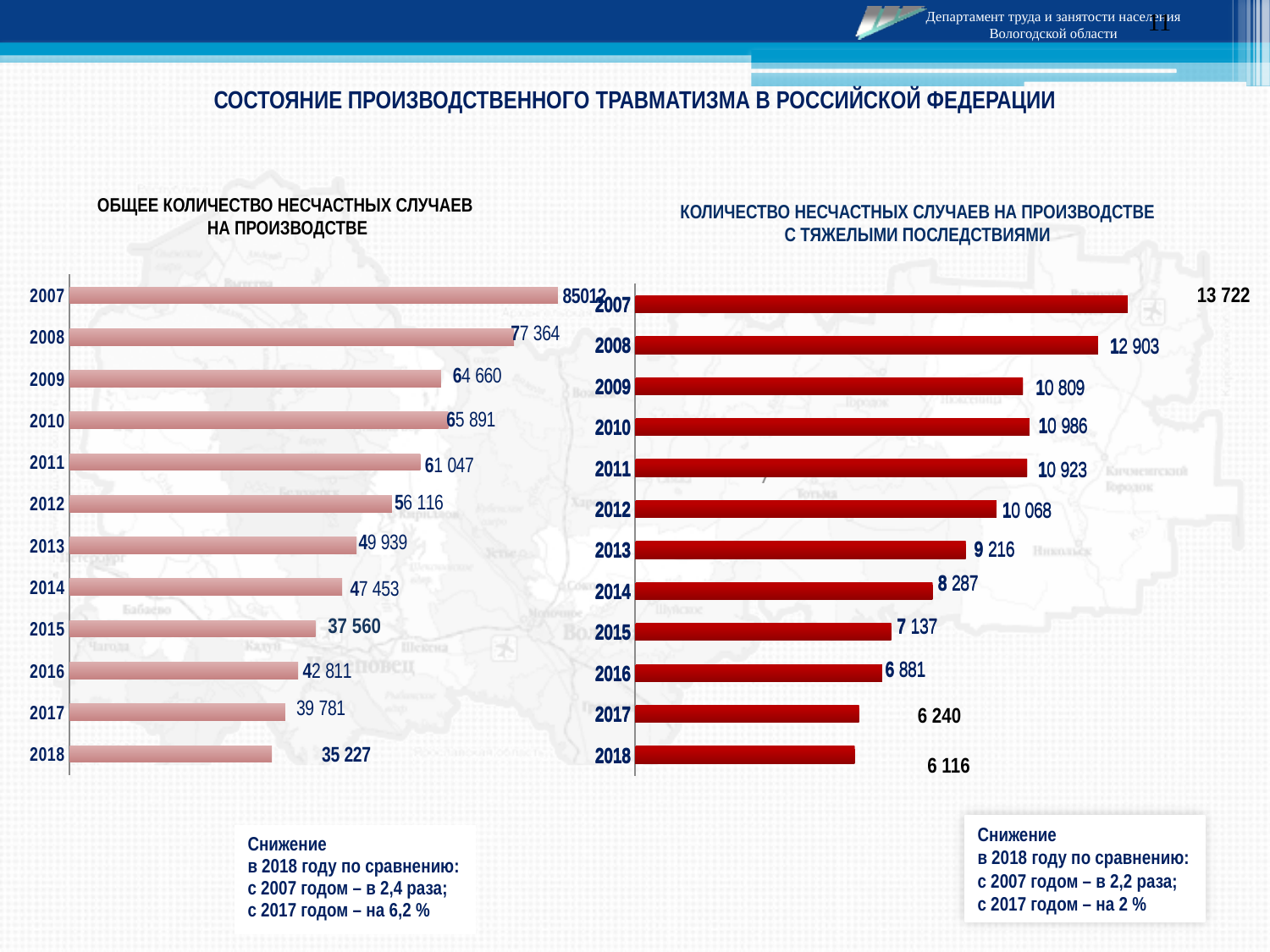
On the right chart (accidents with severe consequences), which year has the lowest value? 2018 How many years are shown on the right chart (accidents with severe consequences)? 12 On the left chart (total number of workplace accidents), what is the value for 2018? 35 227 On the left chart (total number of workplace accidents), which year has the highest value? 2007 What type of chart is the left chart (total number of workplace accidents)? Bar chart On the right chart (accidents with severe consequences), do the values generally rise or fall from 2007 to 2018? Fall On the left chart (total number of workplace accidents), what is the difference between the values for 2017 and 2018? 4 554 On the right chart (accidents with severe consequences), what is the value for 2007? 13 722 On the right chart (accidents with severe consequences), what is the value for 2017? 6 240 On the left chart (total number of workplace accidents), what is the value for 2015? 37 560 On the right chart (accidents with severe consequences), what is the difference between the values for 2007 and 2008? 819